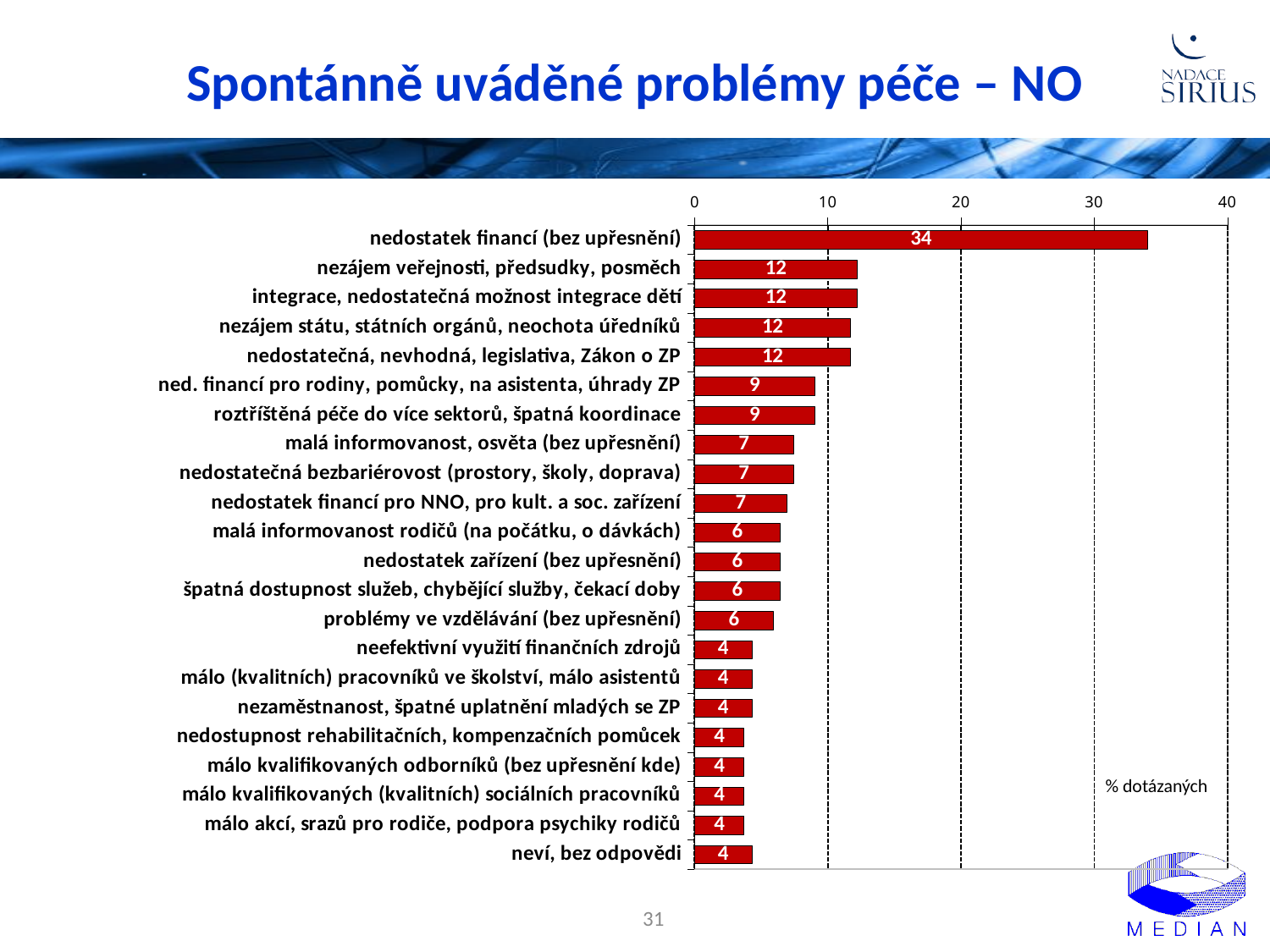
Is the value for "nedostatek financí (bez upřesnění)" greater or less than 30? greater What is the value for "roztříštěná péče do více sektorů, špatná koordinace"? 9 Which is larger: the value for "nedostatečná, nevhodná, legislativa, Zákon o ZP" or the value for "malá informovanost, osvěta (bez upřesnění)"? nedostatečná, nevhodná, legislativa, Zákon o ZP What is the value for "nedostatečná bezbariérovost (prostory, školy, doprava)"? 7 How many categories are shown in the chart? 22 What is the value for "nedostatek financí (bez upřesnění)"? 34 Which category has the highest value? nedostatek financí (bez upřesnění) What kind of chart is shown on the slide? bar chart What is the difference between the values for "ned. financí pro rodiny, pomůcky, na asistenta, úhrady ZP" and "problémy ve vzdělávání (bez upřesnění)"? 3 What is the title of the chart on the slide? Spontánně uváděné problémy péče – NO What is the difference between the values for "nedostatek financí (bez upřesnění)" and "nezájem veřejnosti, předsudky, posměch"? 22 What is the value for "neví, bez odpovědi"? 4